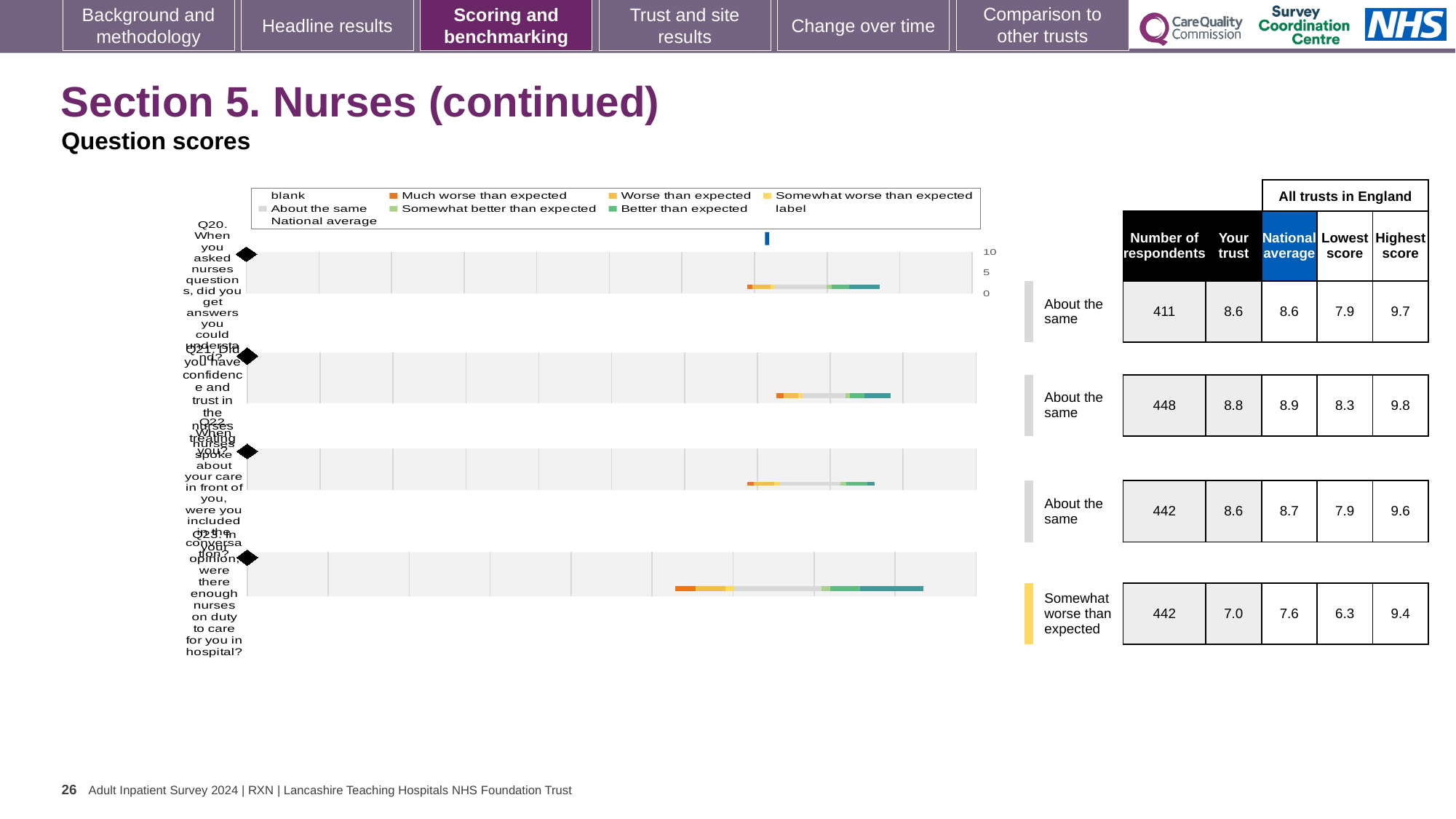
Which question has the highest 'Your trust' score? Q21 Which benchmark category is shown for Q23? Somewhat worse than expected What is the highest score across all trusts in England for Q22? 9.6 Which question has the lowest 'Your trust' score? Q23 What is the difference between the national average and the 'Your trust' score for Q23? 0.6 What is the national average score for Q21 (confidence and trust in the nurses)? 8.9 Is the 'Your trust' score for Q23 greater or less than 5? greater How many questions (rows) are plotted in the chart? 4 For Q21, which is larger: the 'Your trust' score or the national average? National average What kind of chart is shown on the slide? Bar chart What is the 'Your trust' score for Q23 (enough nurses on duty)? 7.0 How many respondents answered Q20? 411